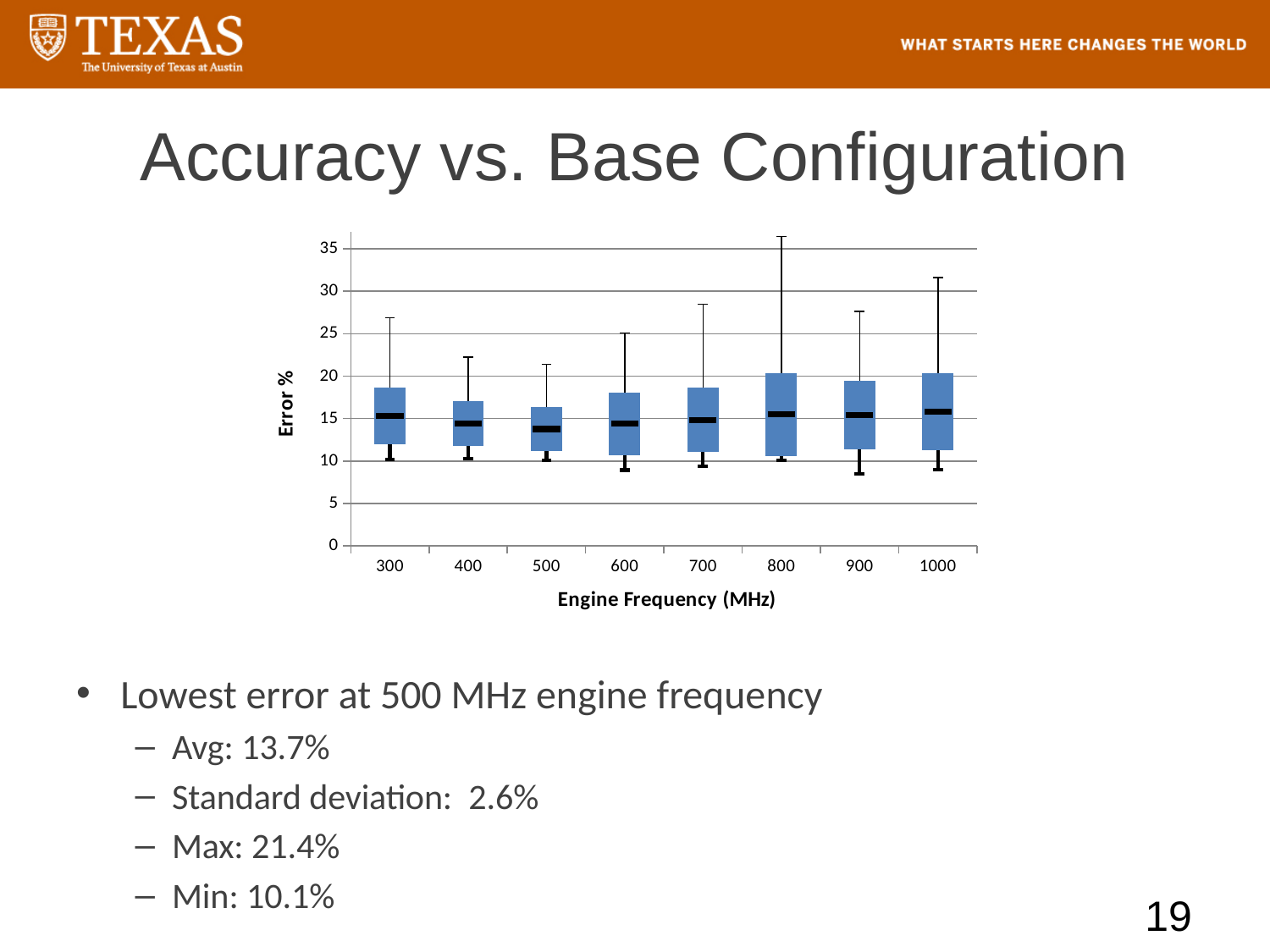
Is the upper whisker for 500 MHz greater or less than 25? less Is the median error for 300 MHz greater or less than 20? less What is the y-axis title of the chart? Error % What kind of chart is shown on the slide? box-and-whisker plot What is the x-axis title of the chart? Engine Frequency (MHz) Which engine frequency has the lowest median error? 500 Which engine frequency has the highest upper whisker (maximum error)? 800 According to the slide, what is the average error at 500 MHz engine frequency? 13.7% Is the lower whisker for 900 MHz greater or less than 10? less Which has the higher upper whisker, 900 MHz or 1000 MHz? 1000 How many engine frequency categories are plotted on the x axis? 8